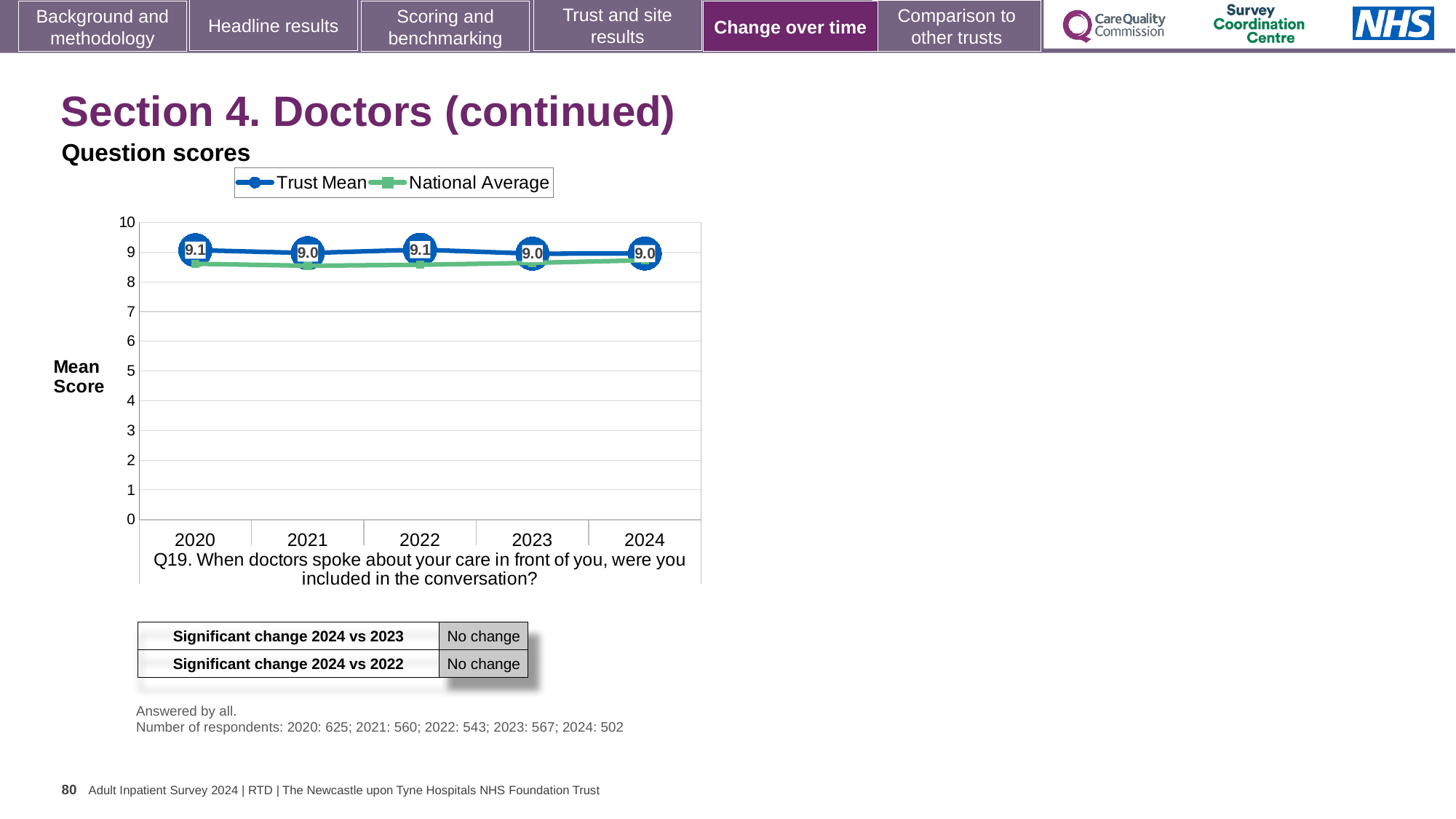
What is the Trust Mean score for 2024? 9.0 In 2022, which is higher, the Trust Mean or the National Average? Trust Mean What is the Trust Mean score for 2020? 9.1 How many series does the chart legend list? 2 What is the difference between the Trust Mean in 2020 and in 2024? 0.1 What is the Trust Mean score for 2022? 9.1 What kind of chart is shown on the slide? line chart What is the Trust Mean score for 2021? 9.0 How many years are shown on the x axis of the chart? 5 Is the National Average value for 2021 greater or less than 9? less Is the National Average value for 2020 greater or less than 8? greater What are the two series named in the chart legend? Trust Mean and National Average